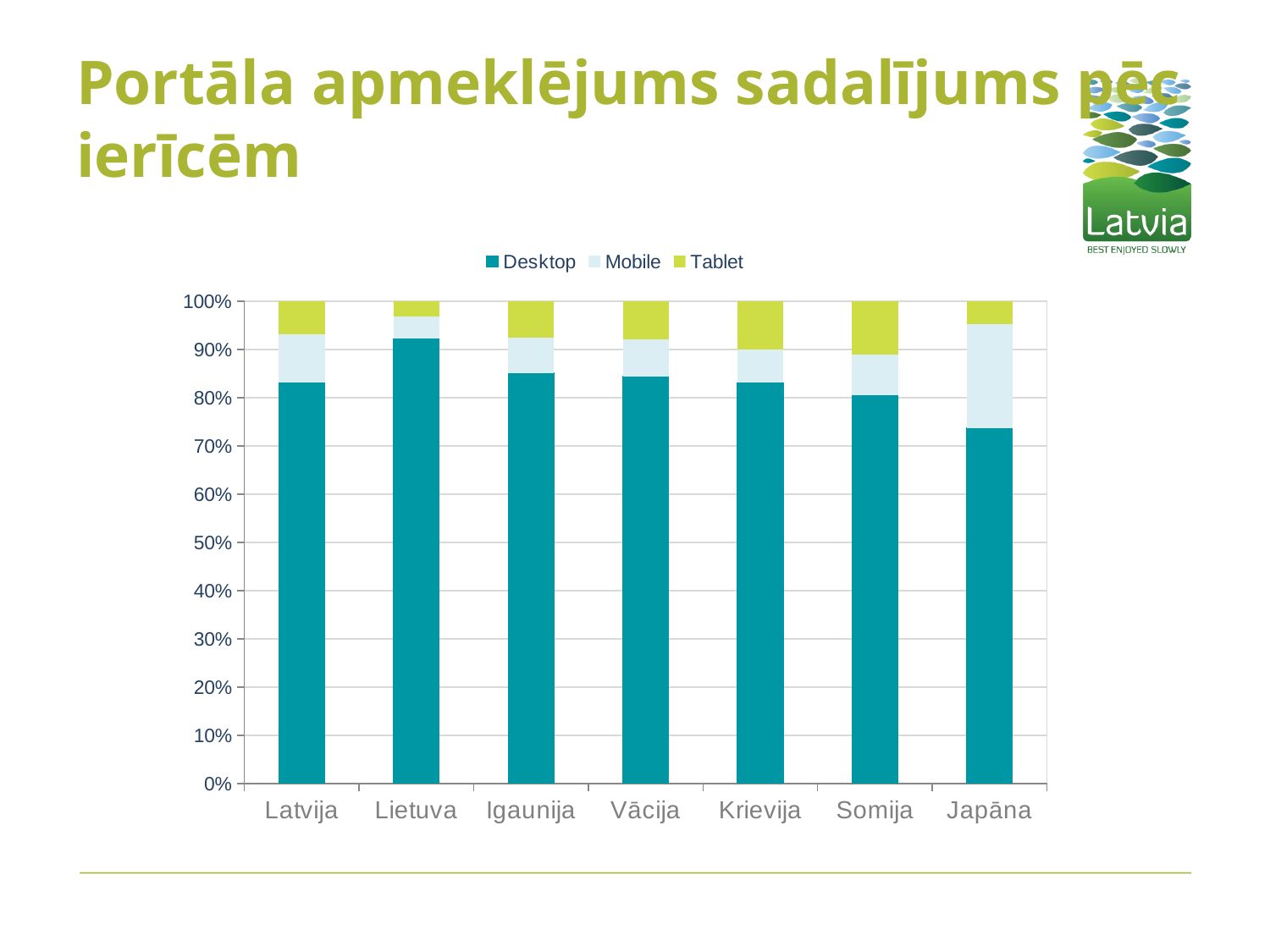
Which country has the largest Desktop share? Lietuva Is the Desktop share for Japāna greater or less than 80%? less Is the Desktop share for Lietuva greater or less than 90%? greater Which country has the smallest Tablet share? Lietuva What kind of chart is shown on the slide? stacked bar chart Which has a larger Desktop share, Lietuva or Japāna? Lietuva Which country has the largest Mobile share? Japāna How many countries are shown on the x axis of the chart? 7 How many series does the chart's legend list? 3 Which series are listed in the chart's legend? Desktop, Mobile, Tablet What is the total of the stacked bar for Latvija? 100% Which country has the smallest Desktop share? Japāna